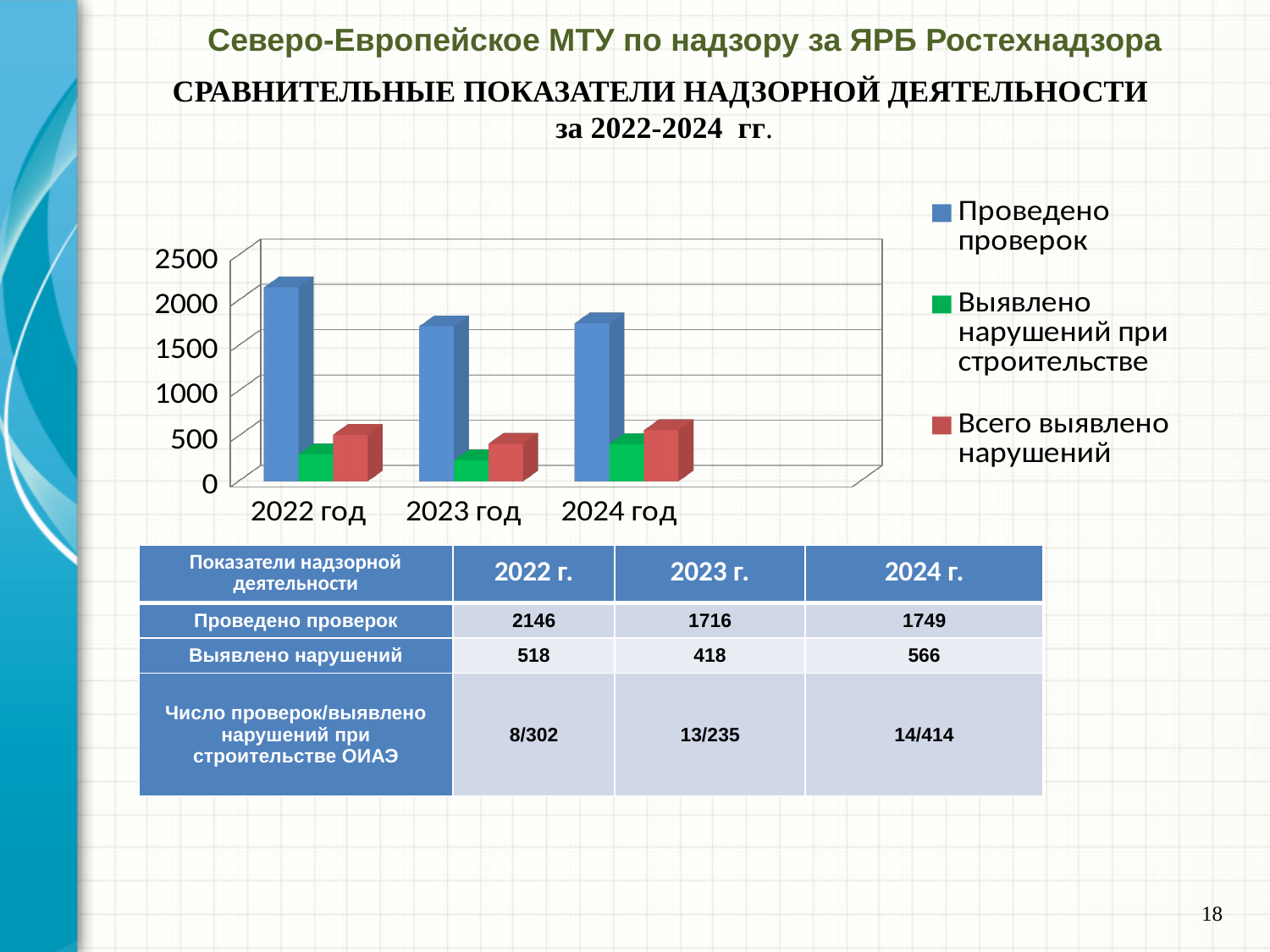
In which year is the "Проведено проверок" bar the highest? 2022 год How many year categories are shown on the x axis of the chart? 3 Which is larger, the "Проведено проверок" value for 2022 год or for 2023 год? 2022 год Is the value for "Выявлено нарушений при строительстве" in 2023 год greater or less than 500? less How many series does the chart legend list? 3 Is the value for "Проведено проверок" in 2023 год greater or less than 2000? less Which colour represents the series "Проведено проверок" in the chart? blue Is the value for "Проведено проверок" in 2022 год greater or less than 2000? greater In which year is the "Выявлено нарушений при строительстве" bar the lowest? 2023 год According to the table on the slide, what is the value of "Проведено проверок" for 2024? 1749 Which series is shown in green in the chart? Выявлено нарушений при строительстве What kind of chart is shown on the slide? bar chart